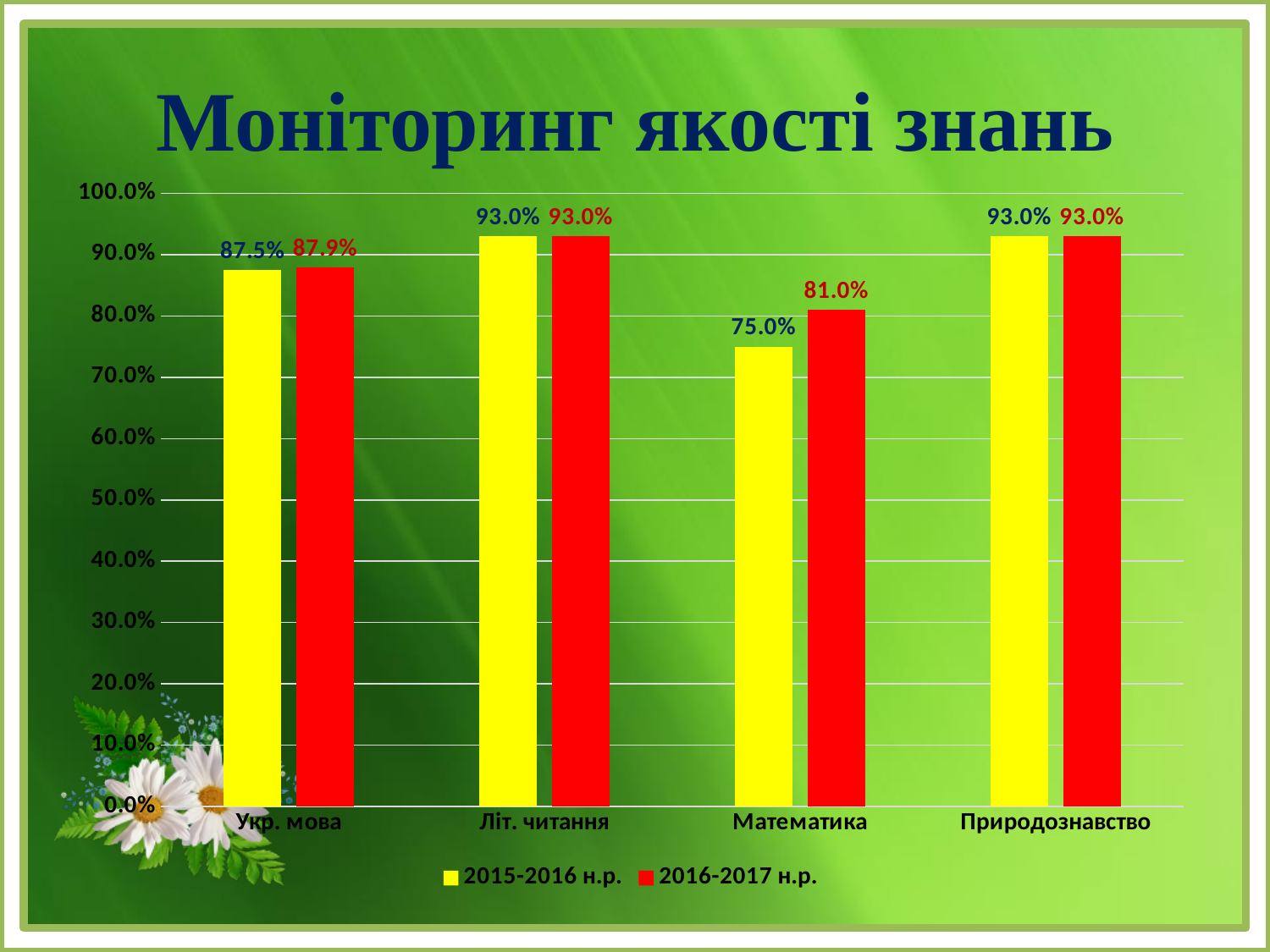
What is the value for Математика in the 2016-2017 н.р. series? 81.0% What is the title of the chart? Моніторинг якості знань What is the value for Математика in the 2015-2016 н.р. series? 75.0% What is the value for Укр. мова in the 2016-2017 н.р. series? 87.9% What is the value for Природознавство in the 2015-2016 н.р. series? 93.0% Which category has the lowest value in the 2016-2017 н.р. series? Математика What is the difference between the 2016-2017 н.р. and 2015-2016 н.р. values for Математика? 6.0% What kind of chart is shown on the slide? Bar chart Which is larger for Математика: the 2015-2016 н.р. value or the 2016-2017 н.р. value? 2016-2017 н.р. Which category has the lowest value in the 2015-2016 н.р. series? Математика How many series does the legend list? 2 How many categories are shown on the x axis? 4